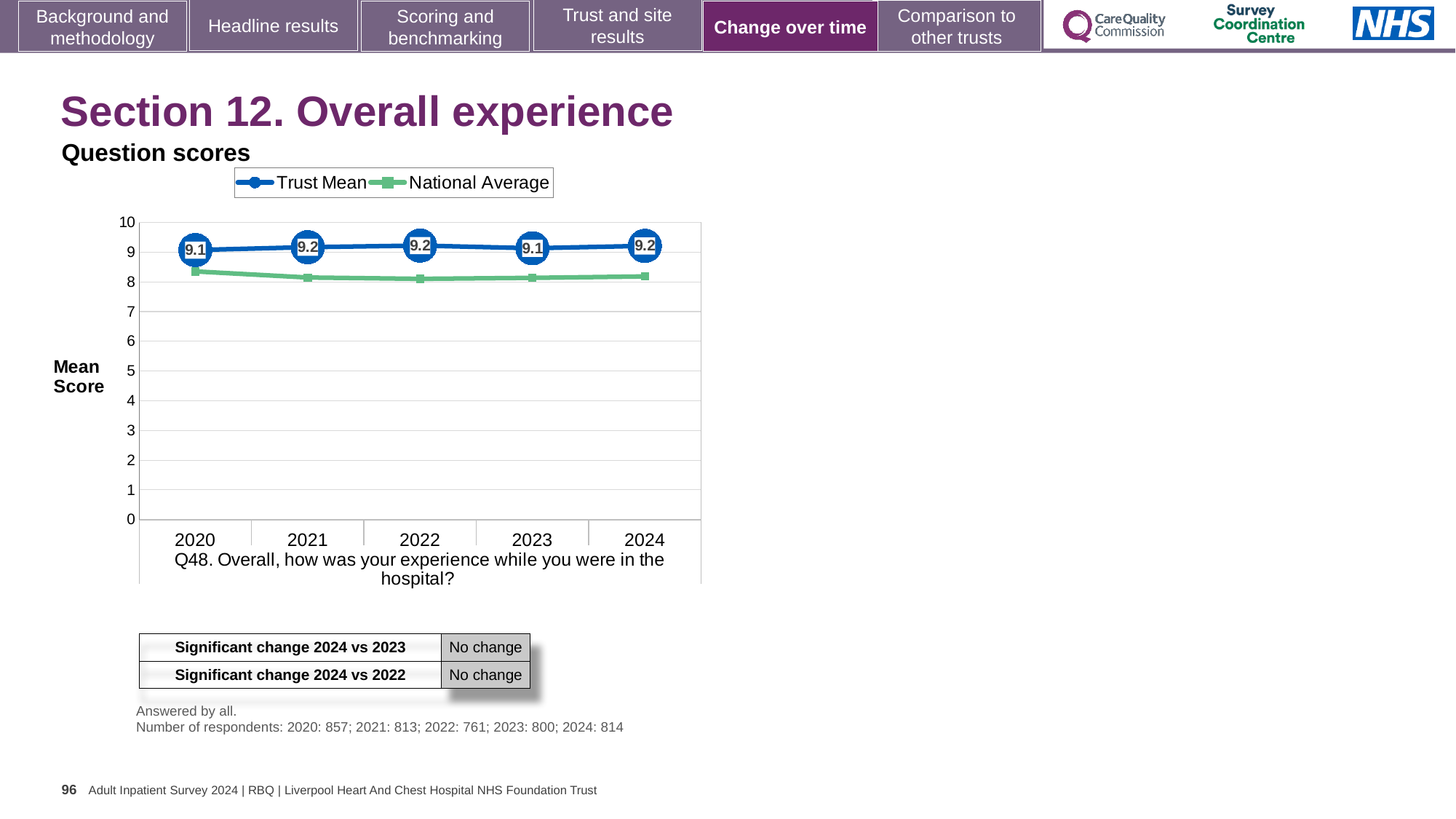
What kind of chart is shown on the slide? line chart What is the Trust Mean score for 2022? 9.2 Is the National Average value for 2022 greater or less than 9? less What is the label of the y axis? Mean Score How many years are shown on the x axis? 5 How many series does the legend list? 2 What is the difference between the Trust Mean scores for 2021 and 2020? 0.1 What is the Trust Mean score for 2020? 9.1 Which series is higher in 2024, Trust Mean or National Average? Trust Mean Is the National Average value for 2020 greater or less than 8? greater What is the Trust Mean score for 2024? 9.2 What is the Trust Mean score for 2023? 9.1